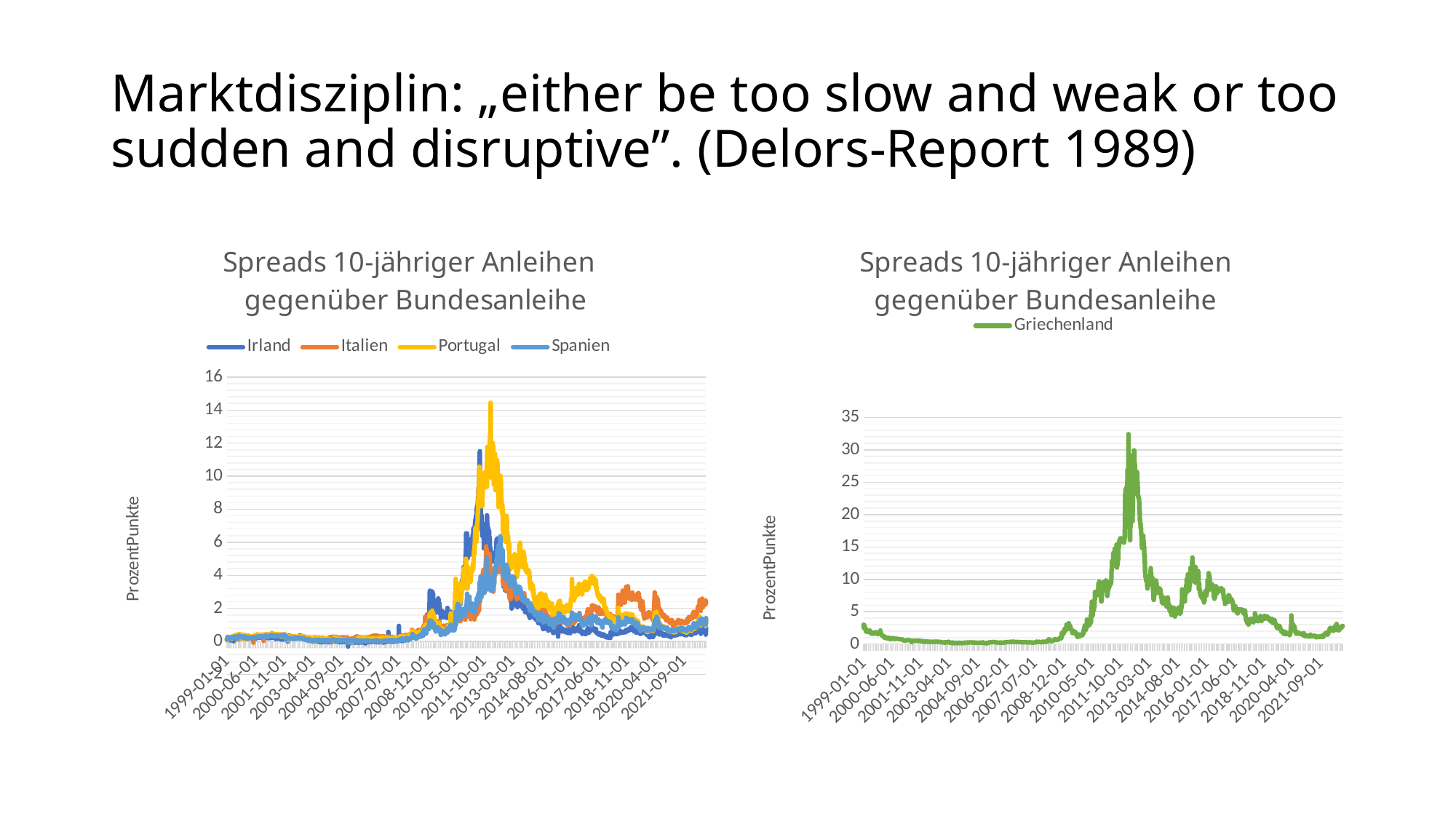
In the right chart, do the values for Griechenland rise or fall overall from their 2012 peak to 2021? Fall What kind of chart is the left chart titled "Spreads 10-jähriger Anleihen gegenüber Bundesanleihe"? Line chart In the left chart, which series has the highest value at the right end of the x axis (2021)? Italien What is the label on the vertical axis of the right chart? ProzentPunkte How many series does the legend of the left chart list? 4 How many series does the legend of the right chart list? 1 In the right chart, is the peak value for Griechenland greater or less than 35? less In the left chart, is the peak value of Portugal greater or less than 12? greater In the right chart, is the peak value for Griechenland greater or less than 30? greater Which country is shown in the legend of the right chart? Griechenland Which chart shows the higher peak spread value, the left chart or the right chart? The right chart (Griechenland) In the left chart, which series reaches the highest peak value? Portugal